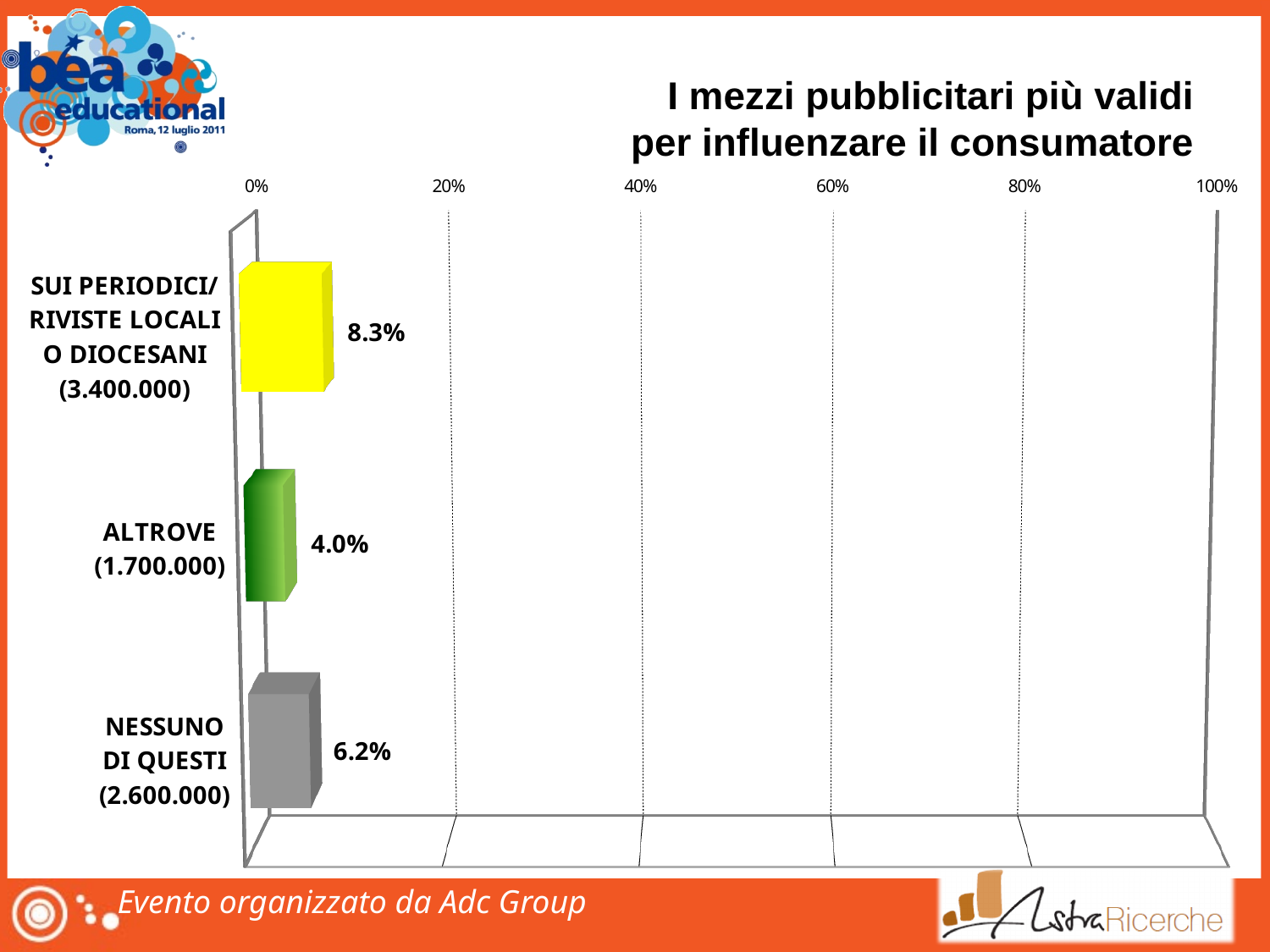
What is the value for SUI PERIODICI/RIVISTE LOCALI O DIOCESANI? 8.3% How many categories are shown in the chart? 3 What is the value for NESSUNO DI QUESTI? 6.2% What is the difference between the values for NESSUNO DI QUESTI and ALTROVE? 2.2% What kind of chart is shown on the slide? bar chart Which category has the highest value? SUI PERIODICI/RIVISTE LOCALI O DIOCESANI What is the difference between the values for SUI PERIODICI/RIVISTE LOCALI O DIOCESANI and ALTROVE? 4.3% What is the title of the chart? I mezzi pubblicitari più validi per influenzare il consumatore Is the value for SUI PERIODICI/RIVISTE LOCALI O DIOCESANI greater or less than 20%? less Which is larger, the value for NESSUNO DI QUESTI or the value for ALTROVE? NESSUNO DI QUESTI Which category has the lowest value? ALTROVE What is the value for ALTROVE? 4.0%